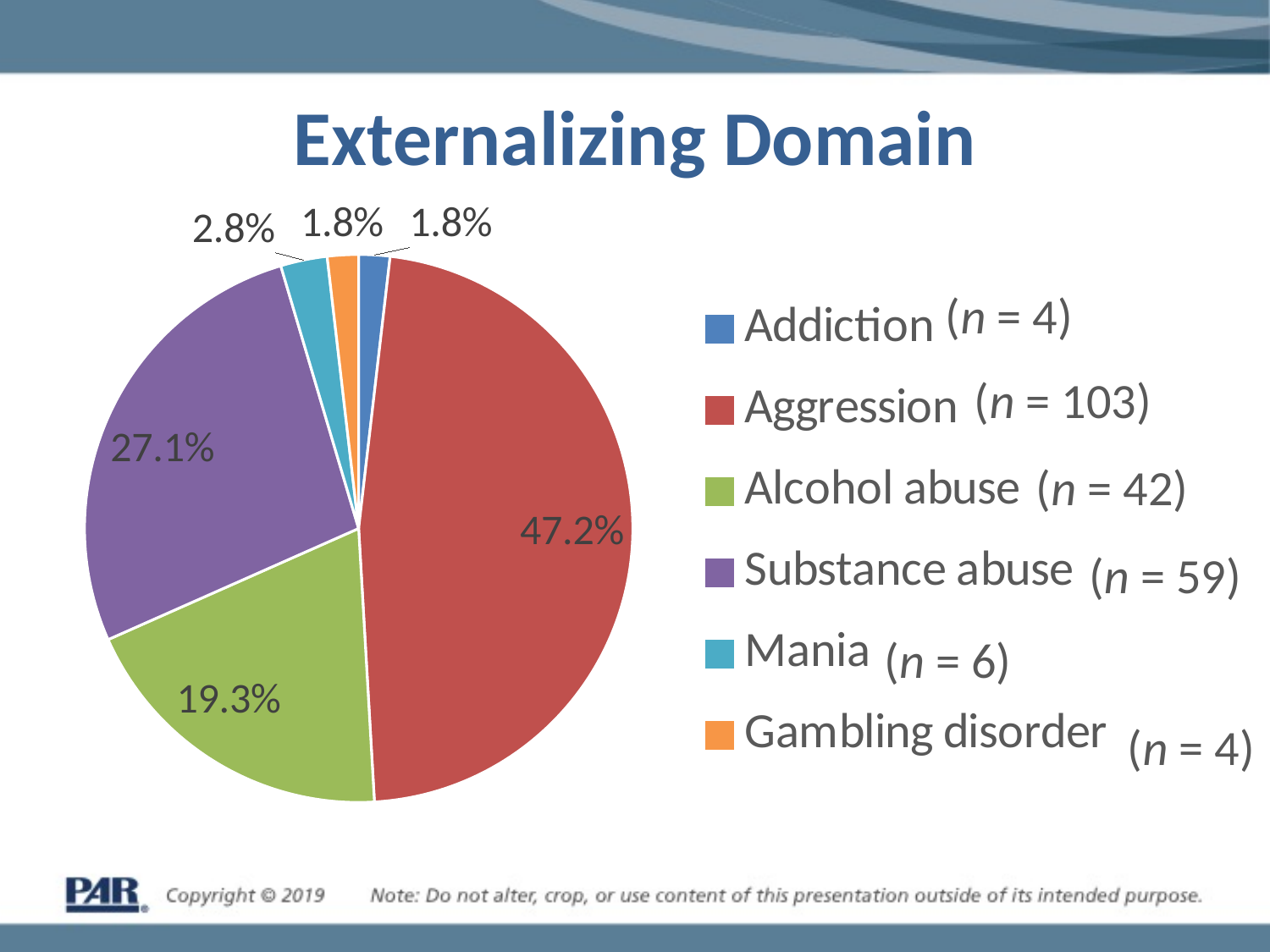
What is the title of the chart? Externalizing Domain According to the legend, what is the n for Aggression? 103 Which slice is larger, Alcohol abuse or Substance abuse? Substance abuse What type of chart is shown on the slide? pie chart What percentage of the pie does Gambling disorder account for? 1.8% What percentage of the pie does Alcohol abuse account for? 19.3% What percentage of the pie does Mania account for? 2.8% How many slices does the pie chart have? 6 What is the difference in percentage points between the Aggression slice and the Substance abuse slice? 20.1 Which category has the largest slice of the pie? Aggression